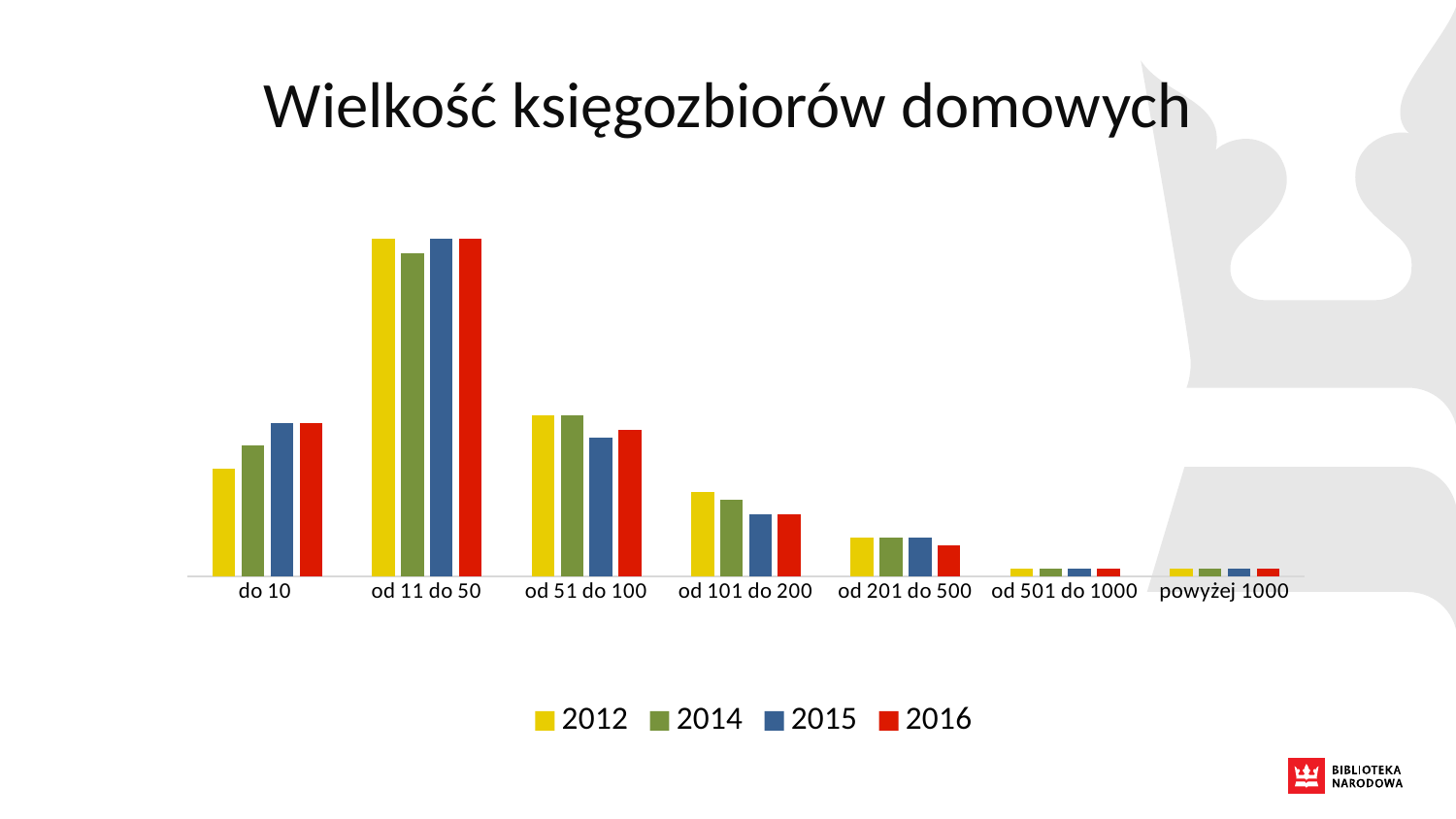
For the category od 51 do 100, which is larger: the value for 2012 or the value for 2015? 2012 What is the title of the chart? Wielkość księgozbiorów domowych For the category od 101 do 200, do the values rise or fall from 2012 through 2014 to 2015? fall Which colour represents the 2016 series in the legend? red Which category has the highest value for the 2016 series? od 11 do 50 For the category od 11 do 50, which is larger: the value for 2012 or the value for 2014? 2012 What kind of chart is shown on the slide? bar chart For the category od 201 do 500, which is larger: the value for 2012 or the value for 2016? 2012 Which category has the highest value for the 2012 series? od 11 do 50 How many categories are shown on the x axis? 7 How many series does the legend list? 4